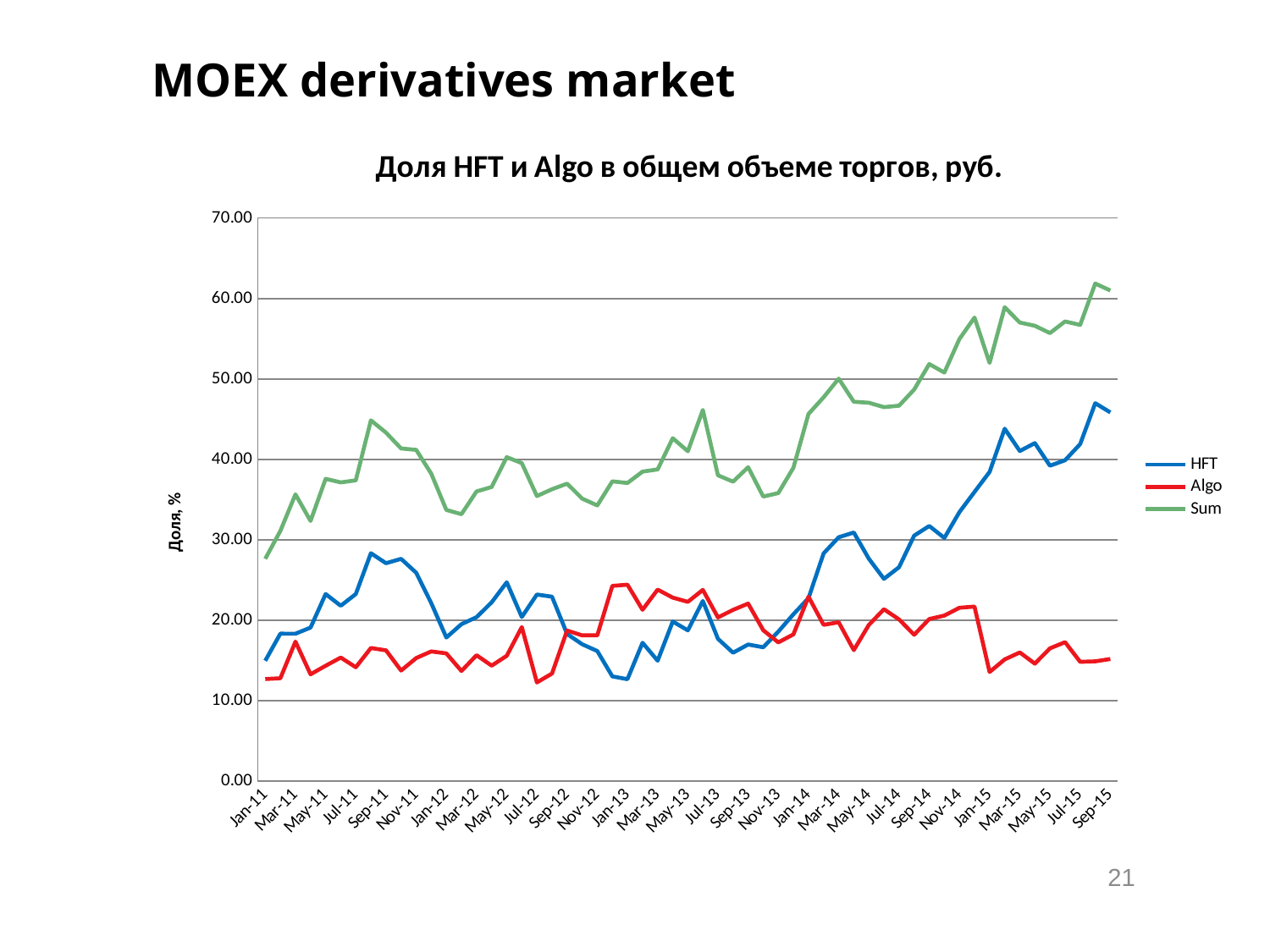
At Jan-13, which is larger: HFT or Algo? Algo Which series has the highest values across the whole period? Sum How many series does the legend list? 3 Is the value of the Algo series at Sep-15 greater or less than 20? less At Sep-15, which is larger: HFT or Algo? HFT What is the title of the chart? Доля HFT и Algo в общем объеме торгов, руб. Is the value of the Sum series at Jan-11 greater or less than 30? less What kind of chart is shown on the slide? line chart Does the Sum series generally rise or fall from Jan-11 to Sep-15? rise What are the series names listed in the legend? HFT, Algo, Sum Is the value of the HFT series at Sep-15 greater or less than 40? greater